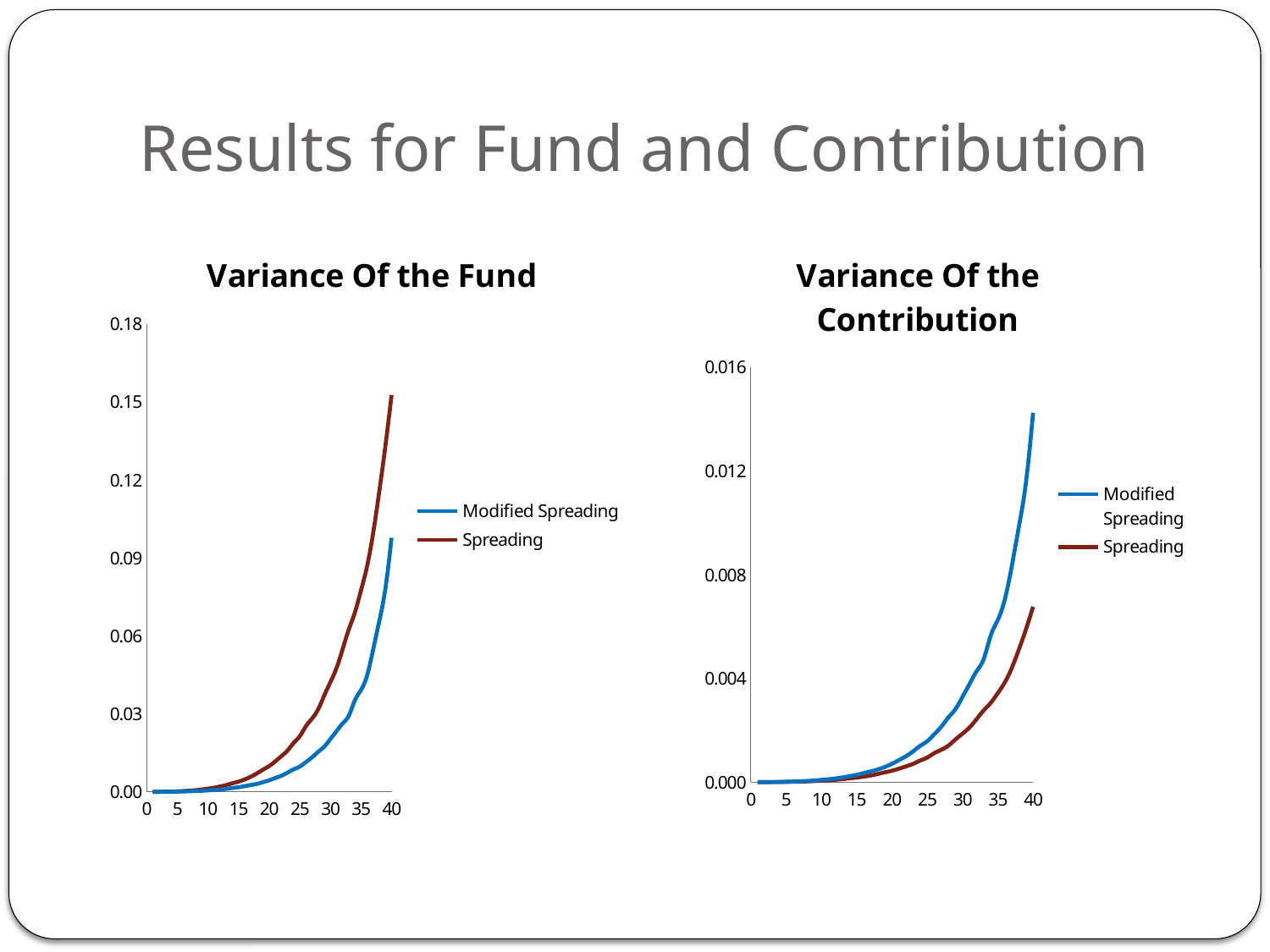
In the "Variance Of the Fund" chart, do the values of the Spreading series rise or fall as x increases from 0 to 40? rise In the "Variance Of the Contribution" chart, is the value of Spreading at x = 40 greater or less than 0.008? less In the "Variance Of the Contribution" chart, which series has the higher value at x = 40, Spreading or Modified Spreading? Modified Spreading In the "Variance Of the Fund" chart, which series has the higher value at x = 40, Spreading or Modified Spreading? Spreading In the "Variance Of the Contribution" chart, which series is shown in blue? Modified Spreading What is the highest value shown on the y axis of the "Variance Of the Contribution" chart? 0.016 In the "Variance Of the Contribution" chart, is the value of Modified Spreading at x = 40 greater or less than 0.012? greater What kind of chart is the "Variance Of the Contribution" chart? line chart How many series does the legend of the "Variance Of the Fund" chart list? 2 In the "Variance Of the Fund" chart, is the value of Spreading at x = 40 greater or less than 0.12? greater What kind of chart is the "Variance Of the Fund" chart? line chart